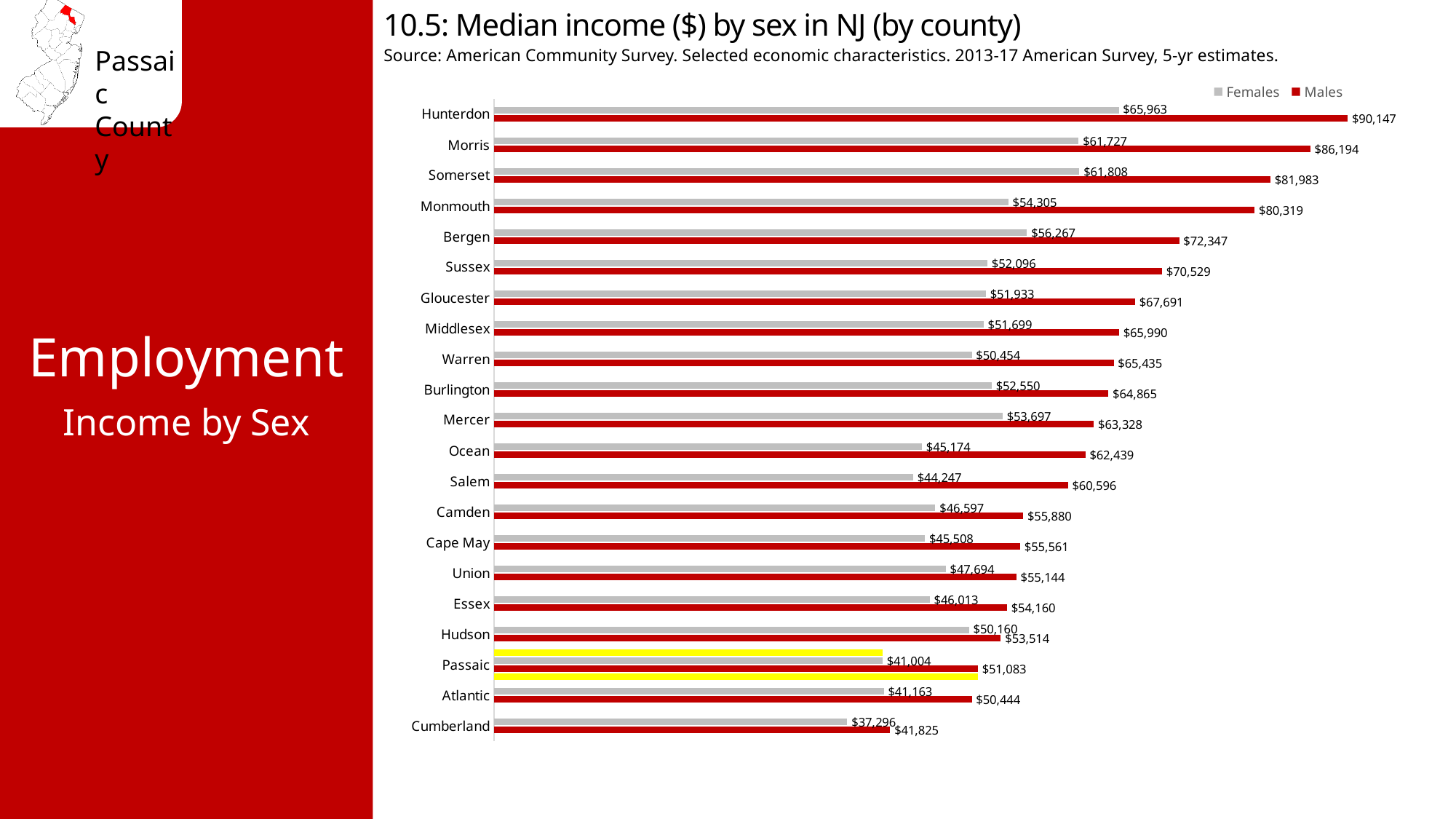
What is the difference between male and female median income in Hunterdon County? $24,184 What kind of chart is shown on the slide? Bar chart What is the median income for females in Hudson County? $50,160 Which county has the highest median income for males? Hunterdon What is the median income for males in Passaic County? $51,083 How many counties are shown in the chart? 21 Which is larger: the female median income in Bergen County or in Monmouth County? Bergen What is the median income for females in Cumberland County? $37,296 Which colour represents Males in the chart? Red Which county has the lowest median income for females? Cumberland What is the difference between male and female median income in Passaic County? $10,079 How many series does the legend list? 2